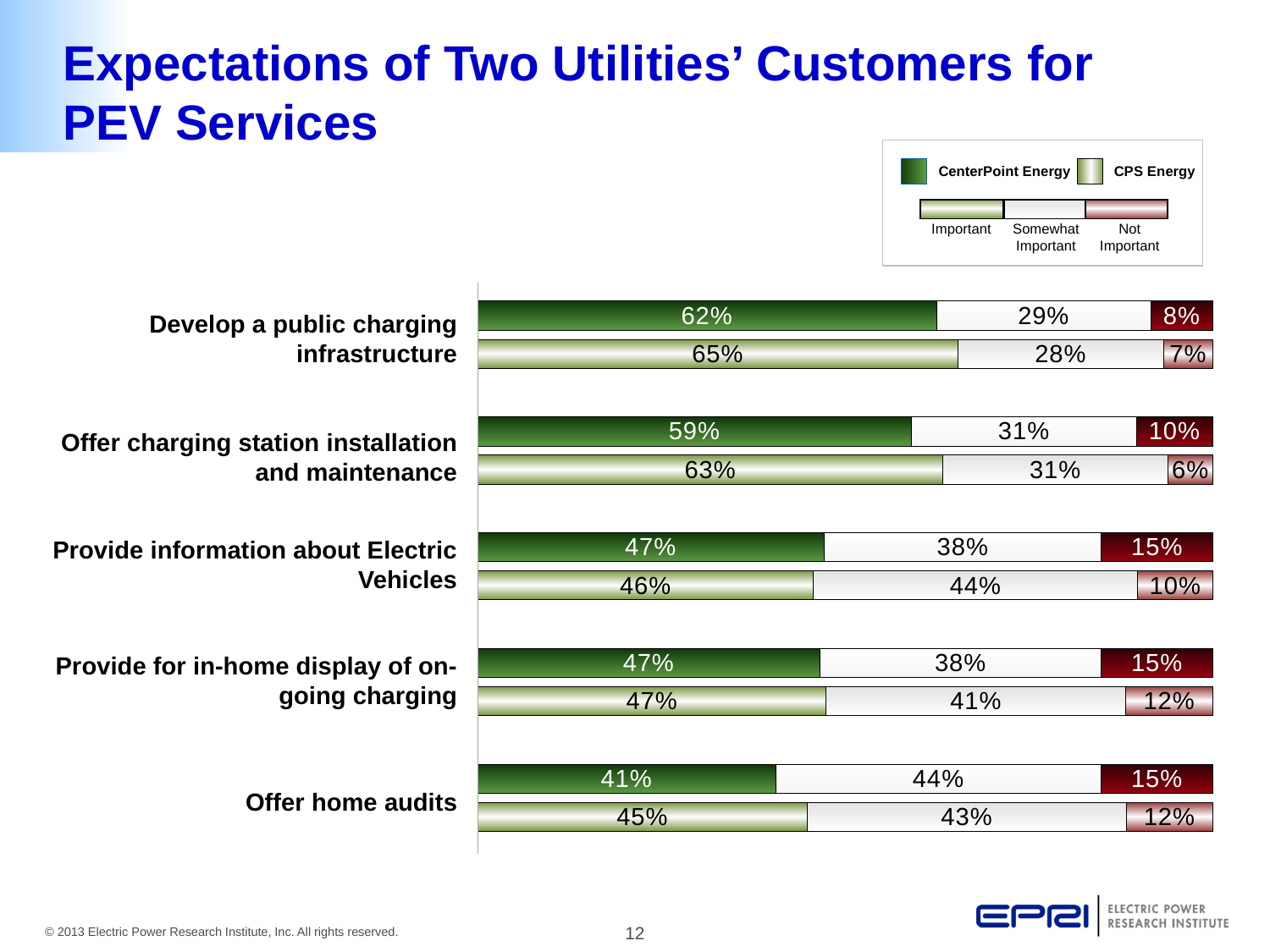
Which service has the lowest Important percentage among CenterPoint Energy customers? Offer home audits Which response category is shown in red in the legend? Not Important What is the difference between the CPS Energy and CenterPoint Energy Important percentages for "Offer charging station installation and maintenance"? 4% For "Offer home audits", which utility's customers have the higher Important percentage, CenterPoint Energy or CPS Energy? CPS Energy What percentage of CPS Energy customers rated "Offer home audits" as Not Important? 12% Which service has the highest Important percentage among CPS Energy customers? Develop a public charging infrastructure What type of chart is shown on the slide? Stacked bar chart What percentage of CenterPoint Energy customers rated "Develop a public charging infrastructure" as Important? 62% What percentage of CPS Energy customers rated "Provide information about Electric Vehicles" as Somewhat Important? 44% How many utilities does the legend list? 2 What is the total of the three segments in the CenterPoint Energy bar for "Provide for in-home display of on-going charging"? 100% How many services are listed on the chart? 5